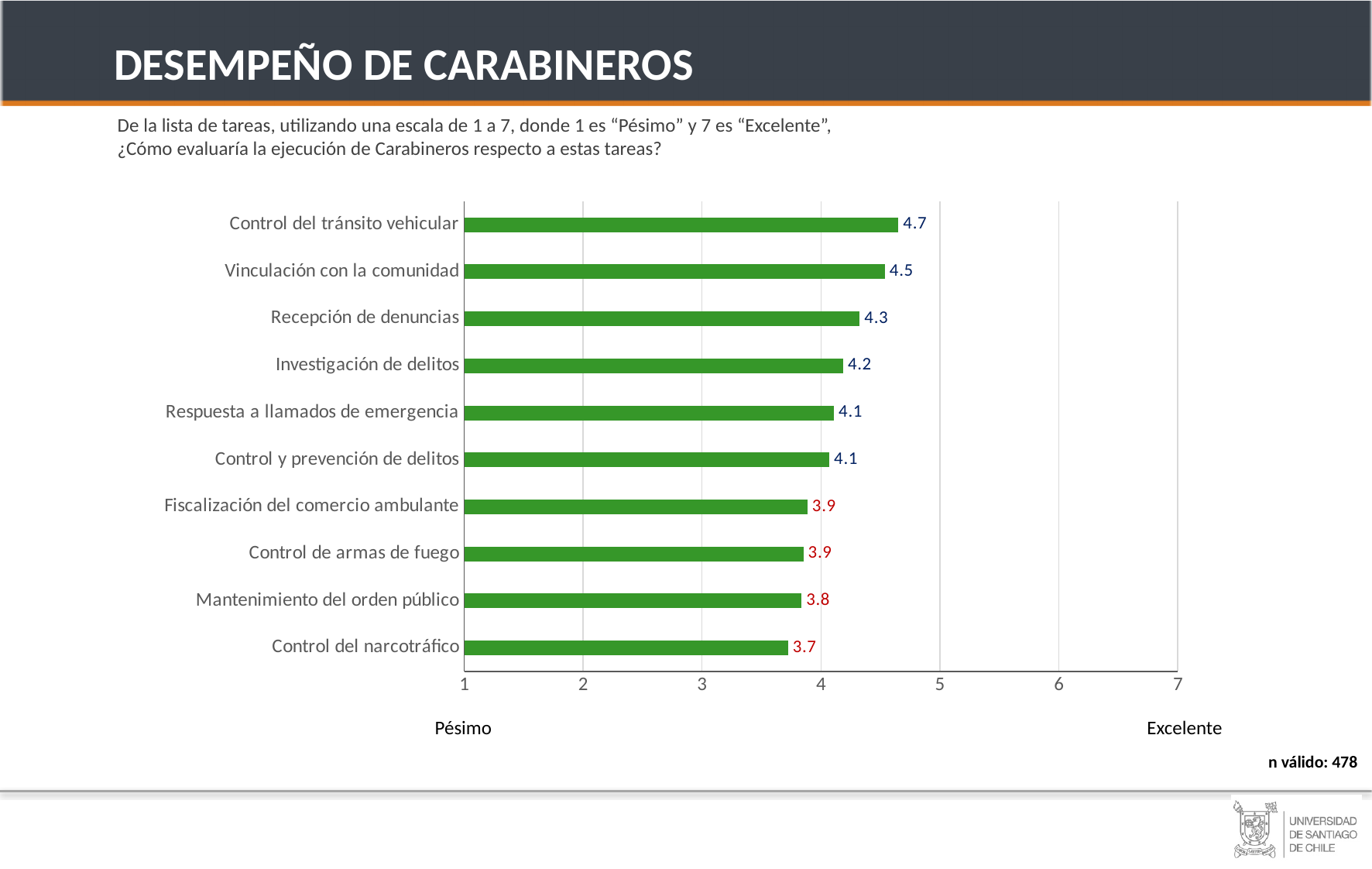
Is the value for Control de armas de fuego greater or less than 4? less What is the valid sample size (n válido) shown on the slide? 478 What kind of chart is shown on the slide? bar chart What is the value for Control del tránsito vehicular? 4.7 What is the difference between the values for Control del tránsito vehicular and Control del narcotráfico? 1.0 How many tasks are shown in the chart? 10 Which task has the highest value? Control del tránsito vehicular Which is larger, the value for Vinculación con la comunidad or the value for Investigación de delitos? Vinculación con la comunidad Which task has the lowest value? Control del narcotráfico What is the value for Recepción de denuncias? 4.3 What is the value for Mantenimiento del orden público? 3.8 What is the difference between the values for Recepción de denuncias and Fiscalización del comercio ambulante? 0.4